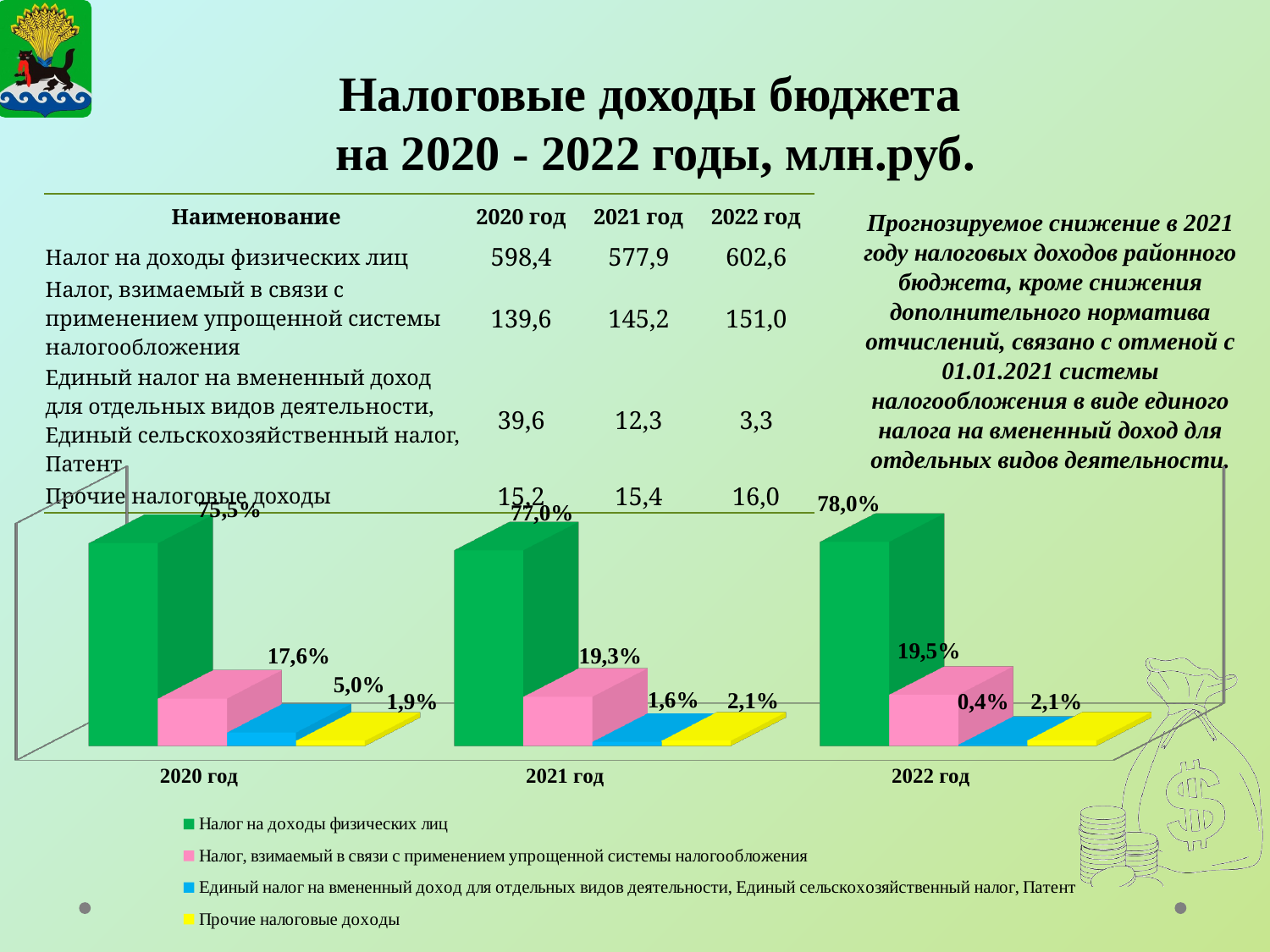
What is the share of 'Прочие налоговые доходы' in 2021 according to the chart? 2,1% What is the share of 'Единый налог на вмененный доход для отдельных видов деятельности, Единый сельскохозяйственный налог, Патент' in 2022 according to the chart? 0,4% What is the difference between the 2020 and 2022 shares of 'Единый налог на вмененный доход для отдельных видов деятельности, Единый сельскохозяйственный налог, Патент' on the chart? 4,6% What kind of chart is shown on the slide? bar chart What is the share of 'Налог, взимаемый в связи с применением упрощенной системы налогообложения' in 2020 according to the chart? 17,6% In which year is the share of 'Единый налог на вмененный доход для отдельных видов деятельности, Единый сельскохозяйственный налог, Патент' the lowest on the chart? 2022 год What is the share of 'Налог на доходы физических лиц' in 2021 according to the chart? 77,0% Does the share of 'Налог, взимаемый в связи с применением упрощенной системы налогообложения' rise or fall from 2020 to 2022 on the chart? rise What is the share of 'Налог на доходы физических лиц' in 2022 according to the chart? 78,0% How many year categories are shown on the chart's x axis? 3 How many series does the chart legend list? 4 In which year is the share of 'Налог на доходы физических лиц' the highest on the chart? 2022 год